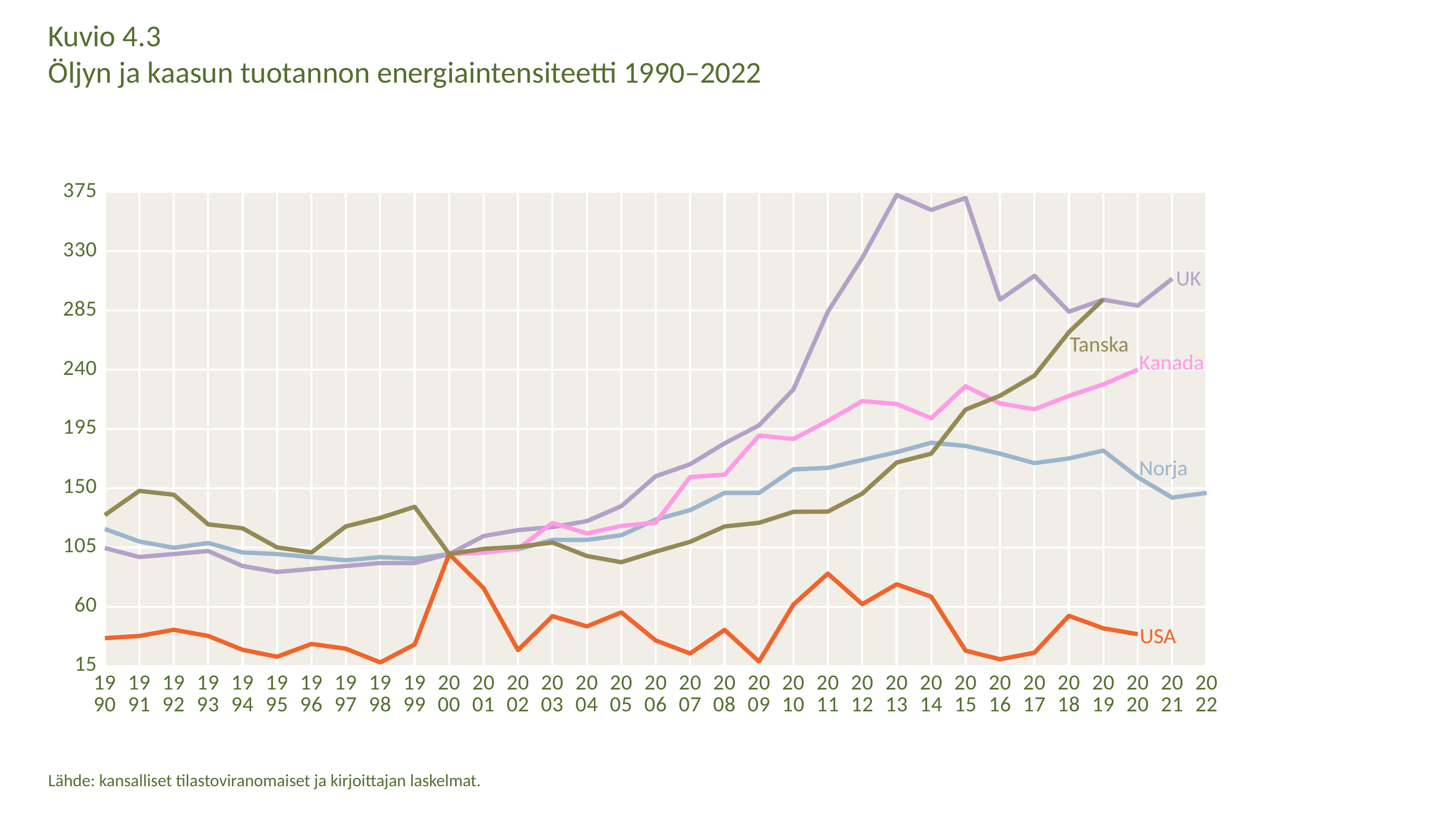
Is the value for Tanska in 2005 greater or less than 105? less Is the value for Norja in 2014 greater or less than 150? greater How many series (countries) are plotted in the chart? 5 How many years are shown on the x axis of the chart? 33 What is the title of the chart? Öljyn ja kaasun tuotannon energiaintensiteetti 1990–2022 Which series reaches the highest value anywhere in the chart? UK Does the Kanada series generally rise or fall from 2000 to 2022? rise Is the value for UK in 2013 greater or less than 330? greater What kind of chart is shown on the slide? line chart In 2019, which is larger: the value for Tanska or the value for Kanada? Tanska